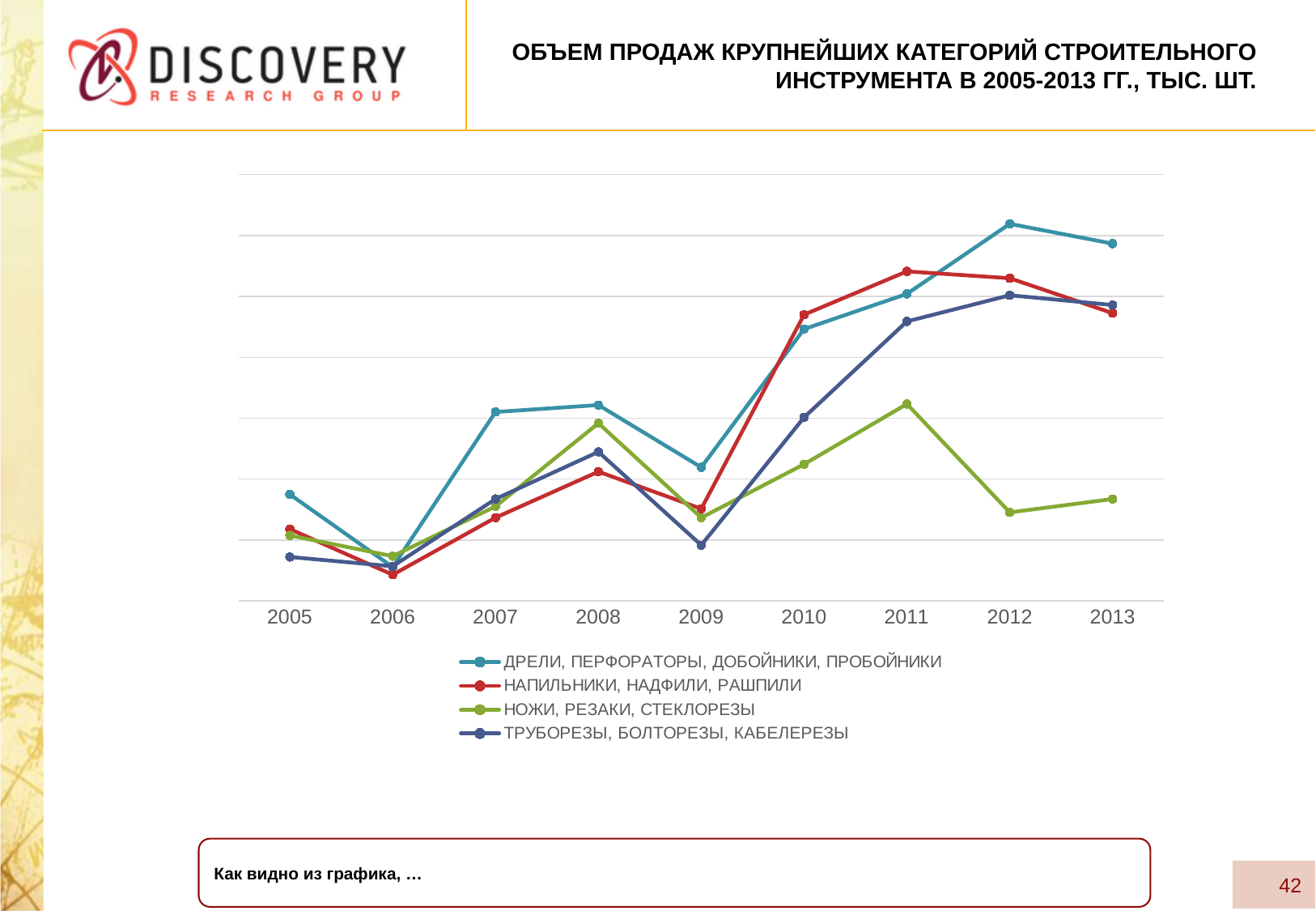
In 2011, which is larger: НАПИЛЬНИКИ, НАДФИЛИ, РАШПИЛИ or ТРУБОРЕЗЫ, БОЛТОРЕЗЫ, КАБЕЛЕРЕЗЫ? НАПИЛЬНИКИ, НАДФИЛИ, РАШПИЛИ How many years are shown on the x axis of the chart? 9 In 2007, which is larger: ДРЕЛИ, ПЕРФОРАТОРЫ, ДОБОЙНИКИ, ПРОБОЙНИКИ or НАПИЛЬНИКИ, НАДФИЛИ, РАШПИЛИ? ДРЕЛИ, ПЕРФОРАТОРЫ, ДОБОЙНИКИ, ПРОБОЙНИКИ In which year does the series НОЖИ, РЕЗАКИ, СТЕКЛОРЕЗЫ reach its highest value? 2011 How many series does the legend list? 4 Which series has the highest value in 2013? ДРЕЛИ, ПЕРФОРАТОРЫ, ДОБОЙНИКИ, ПРОБОЙНИКИ Which series is drawn in red on the chart? НАПИЛЬНИКИ, НАДФИЛИ, РАШПИЛИ In which year is the series НАПИЛЬНИКИ, НАДФИЛИ, РАШПИЛИ at its lowest? 2006 Which series has the lowest value in 2013? НОЖИ, РЕЗАКИ, СТЕКЛОРЕЗЫ In which year does the series ДРЕЛИ, ПЕРФОРАТОРЫ, ДОБОЙНИКИ, ПРОБОЙНИКИ reach its highest value? 2012 What kind of chart is shown on the slide? line chart Does the series НОЖИ, РЕЗАКИ, СТЕКЛОРЕЗЫ rise or fall from 2011 to 2012? fall